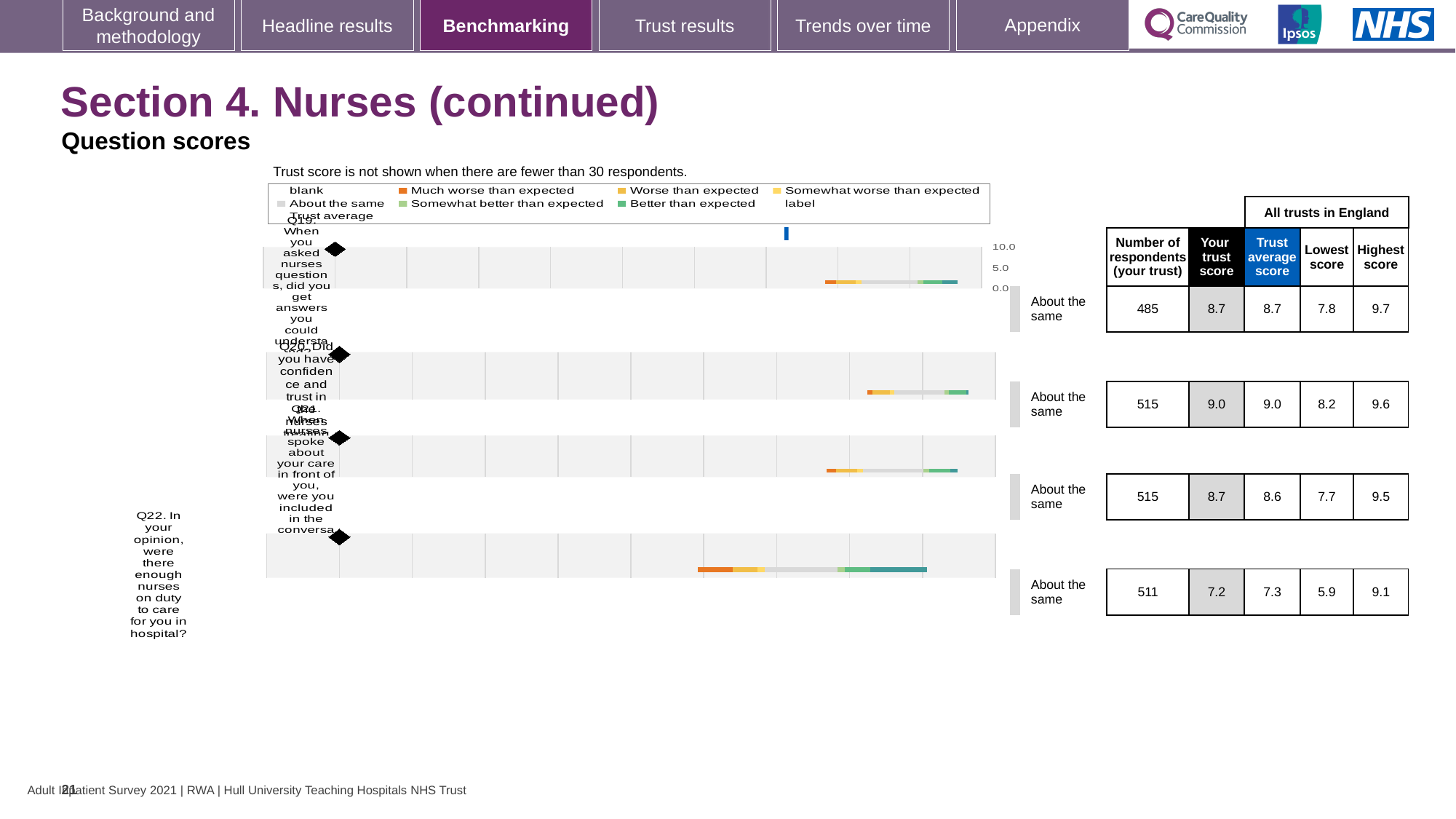
Which question has the lowest 'Your trust score'? Q22 What is the trust average score for Q20? 9.0 What is your trust score for Q22 (were there enough nurses on duty)? 7.2 What is the difference between the highest score and the lowest score for Q22? 3.2 What is the lowest score across all trusts in England for Q22? 5.9 What benchmark category is shown for each of the four questions? About the same What is the highest score across all trusts in England for Q19? 9.7 Which question has the highest 'Your trust score'? Q20 How many questions are shown in the chart? 4 How many respondents from your trust answered Q19? 485 For Q21, is your trust score higher or lower than the trust average score? higher What kind of chart is used to show the question scores? bar chart